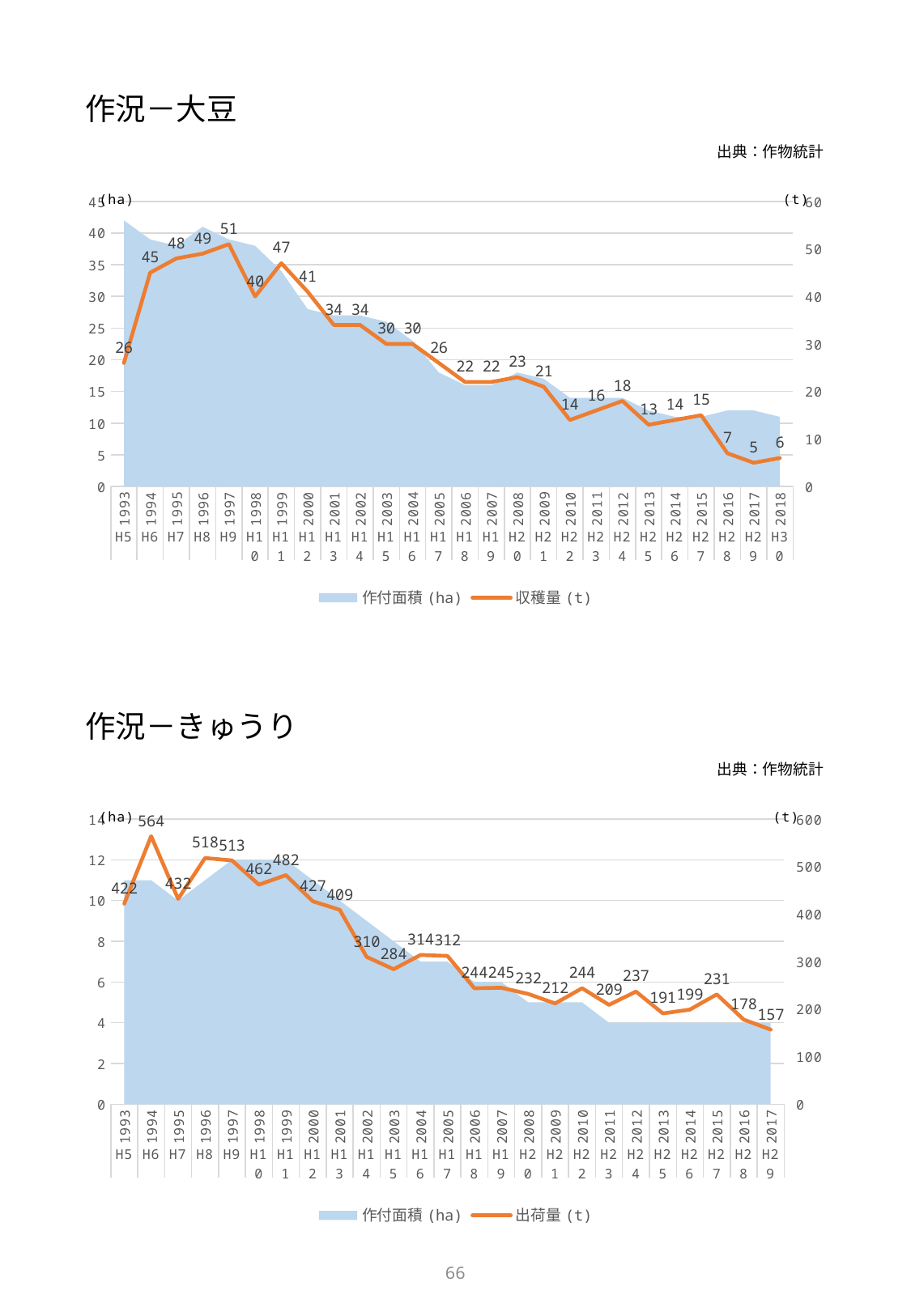
In the 作況－大豆 chart, what is the 収穫量 (t) value for 1997? 51 In the 作況－きゅうり chart, what is the difference in 出荷量 (t) between 2002 and 2003? 26 In the 作況－大豆 chart, what is the difference in 収穫量 (t) between 1997 and 2018? 45 In the 作況－大豆 chart, how many series does the legend list? 2 In the 作況－きゅうり chart, which year has the highest 出荷量 (t)? 1994 In the 作況－大豆 chart, what is the 収穫量 (t) value for 2010? 14 In the 作況－きゅうり chart, what is the 出荷量 (t) value for 1994? 564 In the 作況－大豆 chart, which year has the lowest 収穫量 (t)? 2017 In the 作況－きゅうり chart, does the 出荷量 (t) generally rise or fall from 1994 to 2017? fall In the 作況－きゅうり chart, which is larger, the 出荷量 (t) for 2012 or for 2015? 2012 In the 作況－大豆 chart, is the 作付面積 (ha) for 1993 greater or less than 40? greater In the 作況－きゅうり chart, how many years are plotted on the x axis? 25